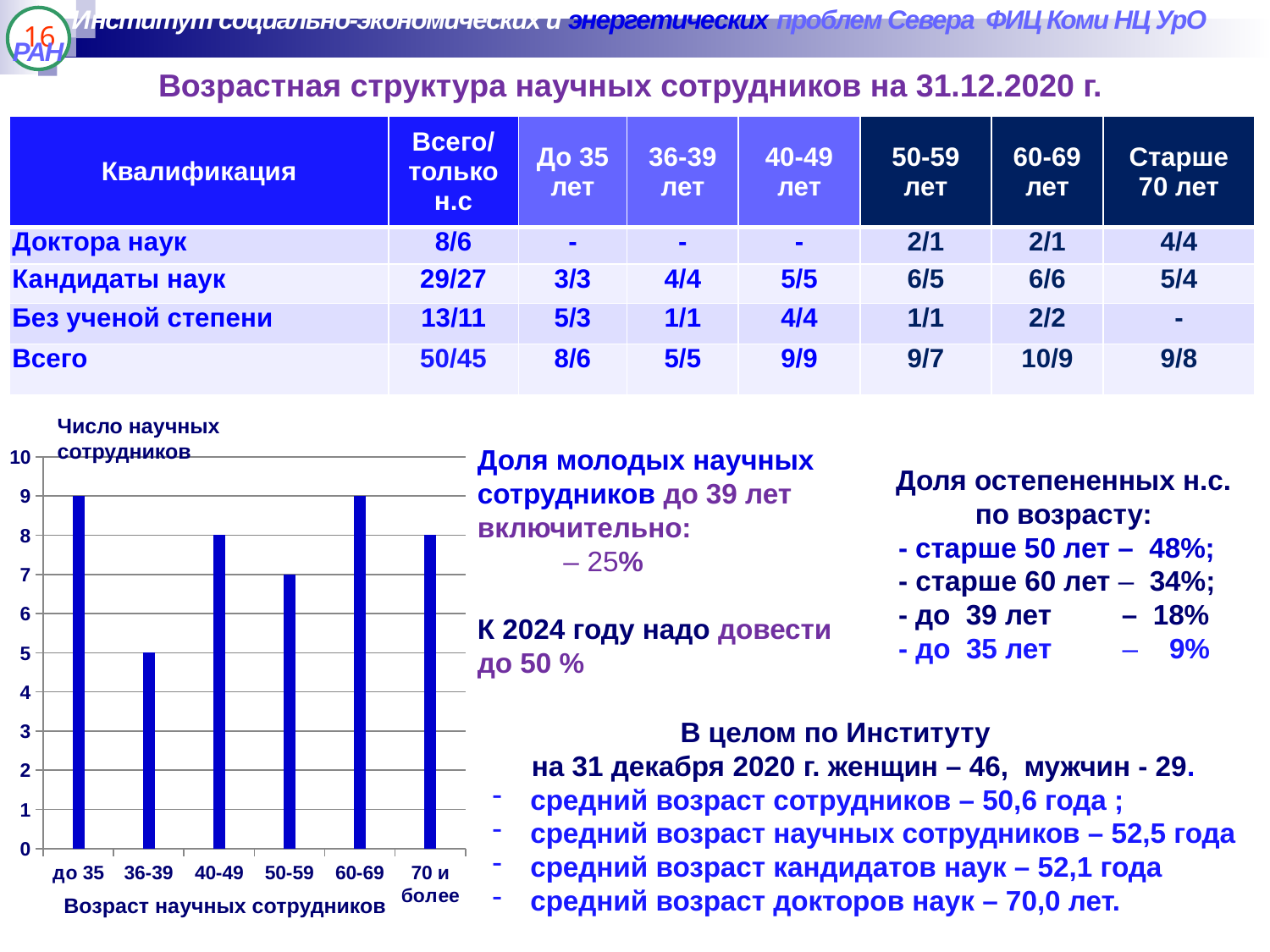
Which is larger in the bar chart: the value for 50-59 or the value for 60-69? 60-69 What is the number of scientific staff in the 50-59 age group according to the bar chart? 7 What kind of chart is shown on the slide? bar chart Which age group has the lowest number of scientific staff in the bar chart? 36-39 What is the number of scientific staff in the 40-49 age group according to the bar chart? 8 What is the label of the y axis of the bar chart? Число научных сотрудников What is the label of the x axis of the bar chart? Возраст научных сотрудников What is the difference between the values for до 35 and 36-39 in the bar chart? 4 How many age categories are shown on the x axis of the bar chart? 6 Which is larger in the bar chart: the value for до 35 or the value for 36-39? до 35 Is the value for 70 и более in the bar chart greater or less than 5? greater What is the number of scientific staff in the 36-39 age group according to the bar chart? 5